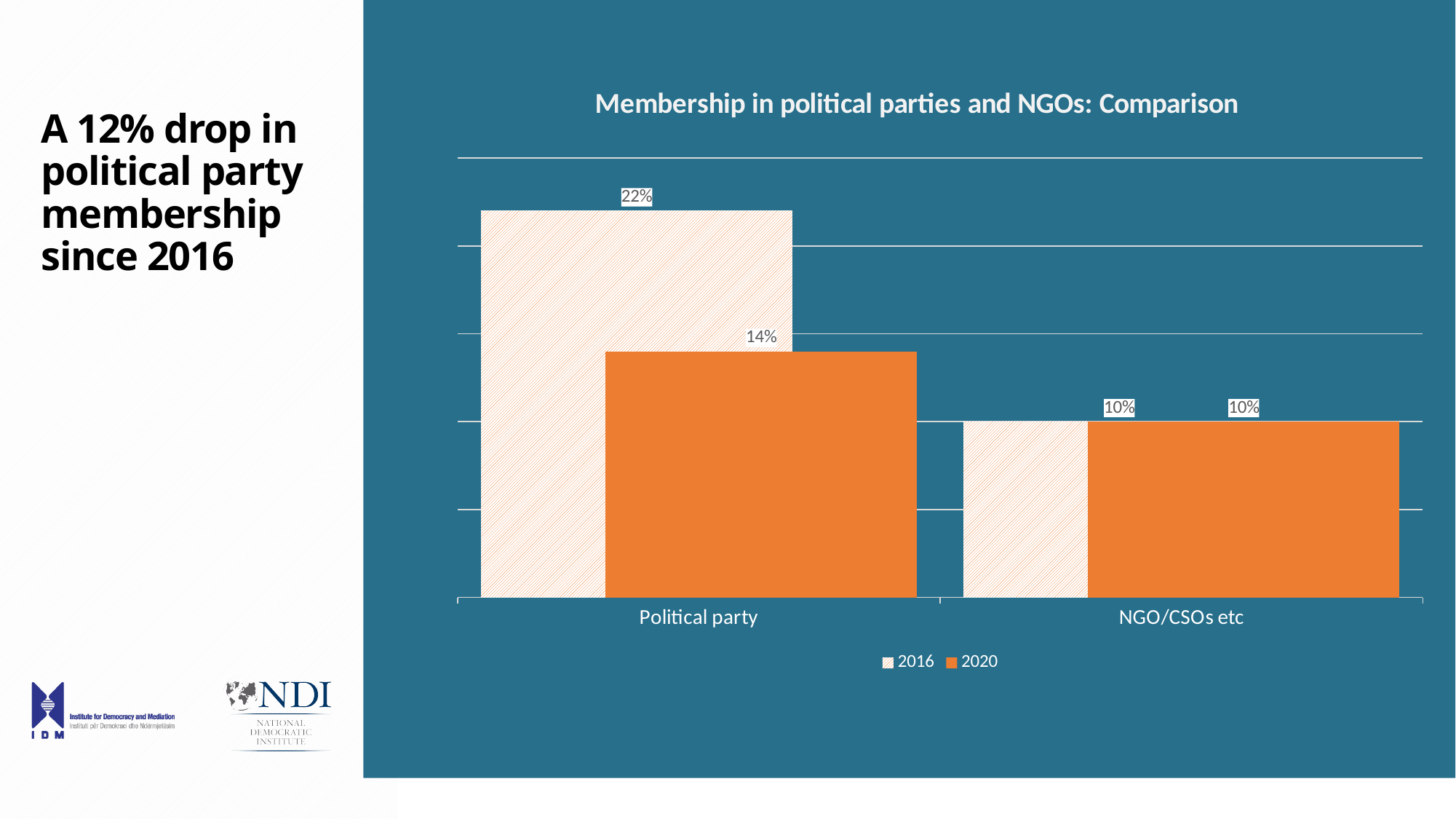
How many series does the legend list? 2 Which is larger for Political party: the 2016 value or the 2020 value? 2016 What is the value for Political party in 2016? 22% What is the difference between the 2016 and 2020 values for Political party? 8% How many categories are shown on the x axis? 2 What is the value for NGO/CSOs etc in 2020? 10% What is the value for Political party in 2020? 14% Which category has the highest value in the 2016 series? Political party Which category has the lowest value in the 2020 series? NGO/CSOs etc What is the value for NGO/CSOs etc in 2016? 10% What is the title of the chart? Membership in political parties and NGOs: Comparison What kind of chart is shown on the slide? Bar chart